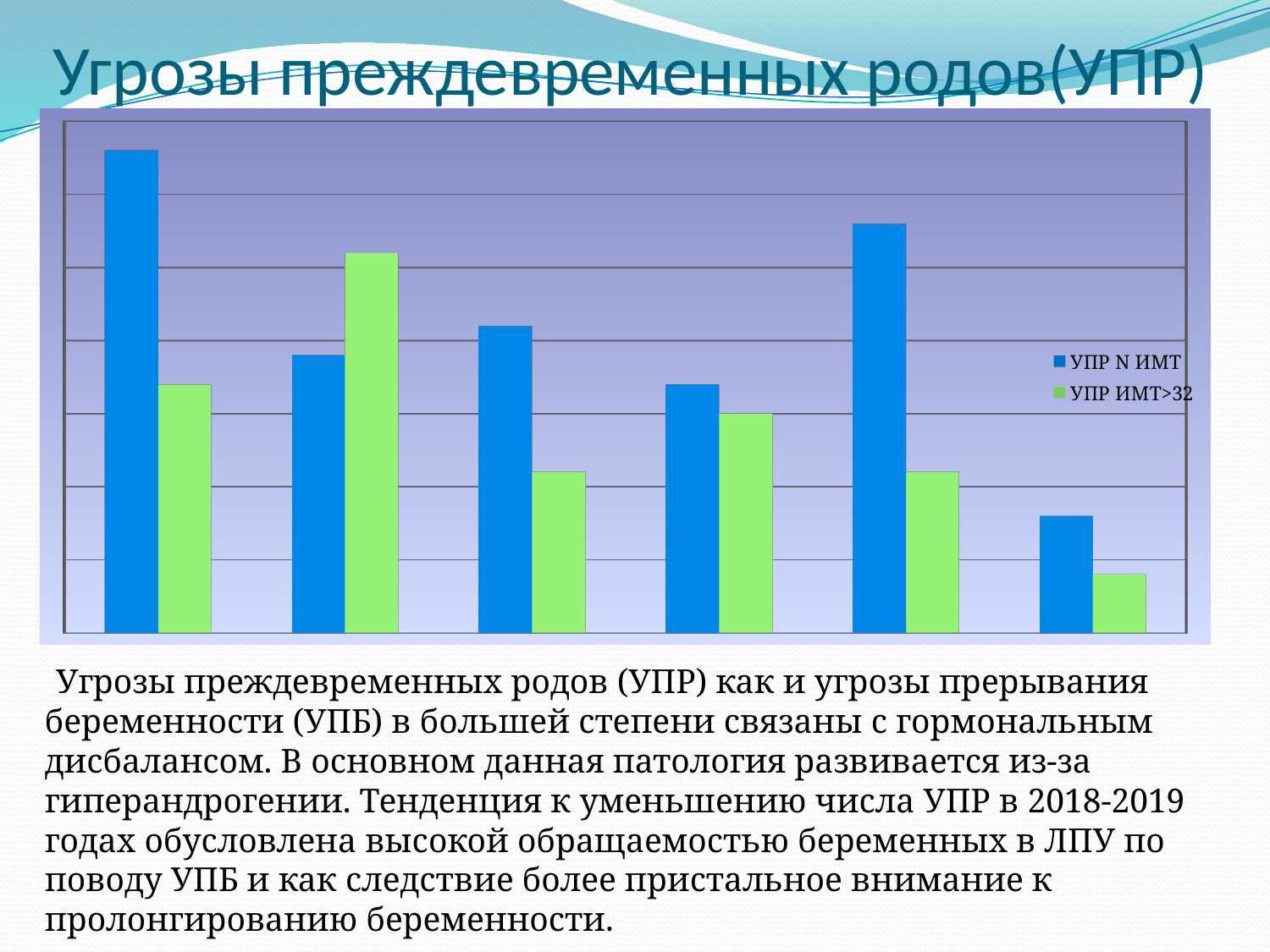
How many groups of bars are plotted in the chart? 6 How many series does the chart legend list? 2 What kind of chart is shown on the slide? bar chart In the leftmost group of bars, which series has the taller bar? УПР N ИМТ In the rightmost group of bars, which series has the taller bar? УПР N ИМТ Which group of bars contains the shortest bar for the series УПР ИМТ>32? the rightmost group What are the two series named in the chart legend? УПР N ИМТ and УПР ИМТ>32 Which group of bars contains the tallest bar for the series УПР N ИМТ? the leftmost group Which group of bars contains the tallest bar for the series УПР ИМТ>32? the second group from the left In the second group of bars from the left, which series has the taller bar? УПР ИМТ>32 Which colour represents the series УПР ИМТ>32 in the chart? green